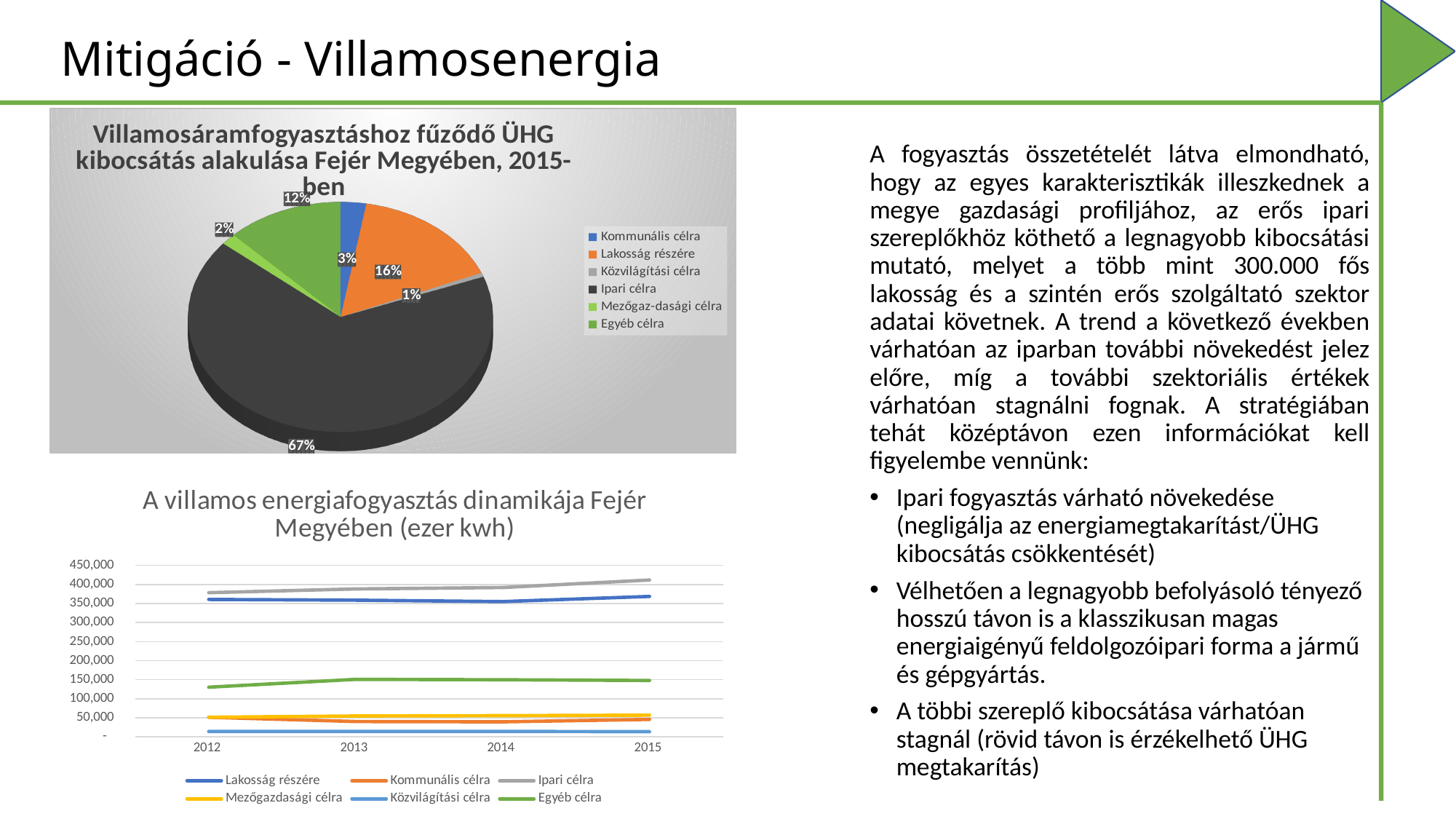
In the bottom line chart, does the value for Ipari célra rise or fall from 2012 to 2015? rise In the pie chart at the top of the slide, how many categories are shown in the legend? 6 In the bottom line chart, how many series does the legend list? 6 In the pie chart at the top of the slide, which category has the largest share? Ipari célra In the pie chart at the top of the slide, what share does Lakosság részére have? 16% In the pie chart at the top of the slide, which category has the smallest share? Közvilágítási célra In the bottom line chart, is the value for Közvilágítási célra in 2013 greater or less than 50,000? less In the bottom line chart, is the value for Ipari célra in 2015 greater or less than 400,000? greater What type of chart is the bottom chart titled 'A villamos energiafogyasztás dinamikája Fejér Megyében (ezer kwh)'? Line chart In the pie chart at the top of the slide, what share does Egyéb célra have? 12% In the pie chart at the top of the slide, what share does Ipari célra have? 67% In the pie chart at the top of the slide, what is the difference between the shares of Ipari célra and Lakosság részére? 51%